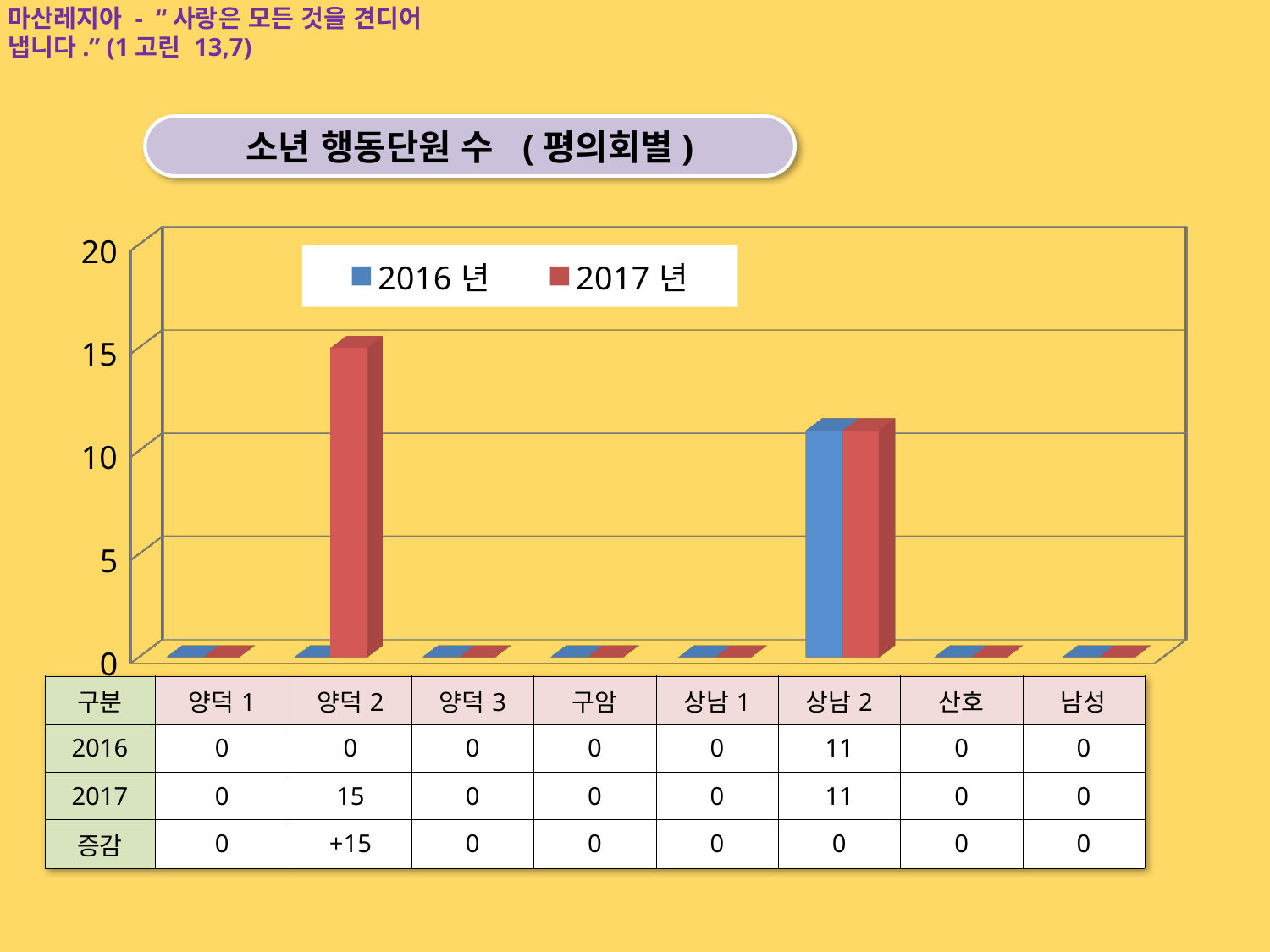
Which is larger for 2017 년: the value for 양덕 2 or the value for 상남 2? 양덕 2 How many series does the legend list? 2 What kind of chart is shown on the slide? bar chart What is the value for 양덕 2 in the 2017 년 series? 15 What is the difference between the 2017 년 value and the 2016 년 value for 양덕 2? 15 How many categories are shown on the x axis of the chart? 8 Which category has the highest value in the 2017 년 series? 양덕 2 What is the title of the chart? 소년 행동단원 수 (평의회별) What is the value for 상남 2 in the 2016 년 series? 11 What is the value for 양덕 2 in the 2016 년 series? 0 Which category has the highest value in the 2016 년 series? 상남 2 Is the 2017 년 value for 양덕 2 greater or less than 10? greater